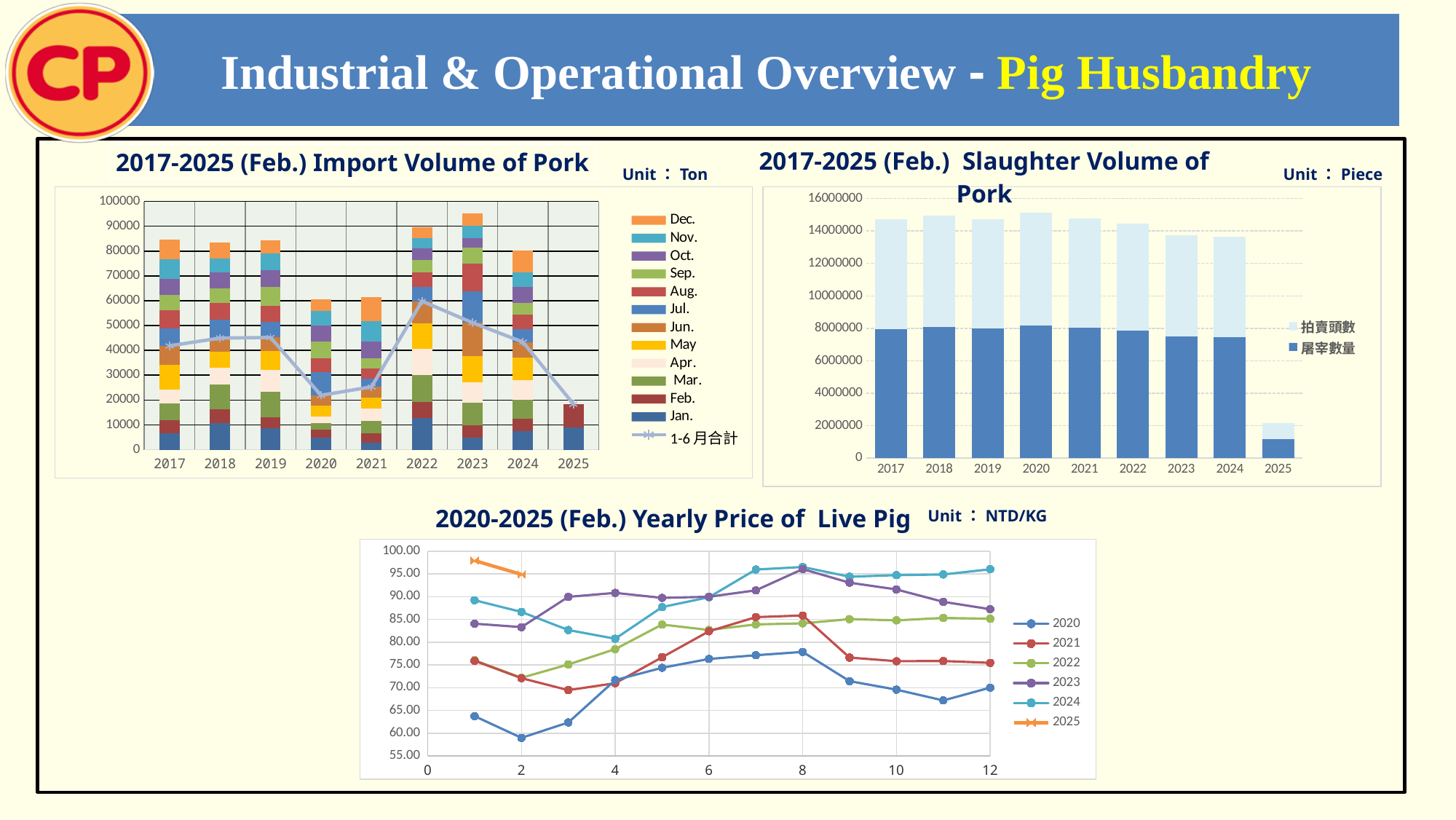
How many series does the legend of the '2017-2025 (Feb.) Slaughter Volume of Pork' chart list? 2 How many years are shown on the x axis of the '2017-2025 (Feb.) Import Volume of Pork' chart? 9 In the '2017-2025 (Feb.) Import Volume of Pork' chart, which year has the highest total import volume? 2023 In the '2017-2025 (Feb.) Import Volume of Pork' chart, is the total for 2023 greater or less than 90000? greater In the '2020-2025 (Feb.) Yearly Price of Live Pig' chart, is the 2020 value at month 2 greater or less than 60.00? less In the '2017-2025 (Feb.) Slaughter Volume of Pork' chart, is the total for 2025 greater or less than 4000000? less What kind of chart is the '2017-2025 (Feb.) Import Volume of Pork' chart? stacked bar chart with a line In the '2017-2025 (Feb.) Slaughter Volume of Pork' chart, which year has the lowest total? 2025 How many series does the legend of the '2020-2025 (Feb.) Yearly Price of Live Pig' chart list? 6 In the '2020-2025 (Feb.) Yearly Price of Live Pig' chart, which is larger at month 12: the 2024 value or the 2020 value? 2024 In the '2017-2025 (Feb.) Import Volume of Pork' chart, which year has the lowest total import volume? 2025